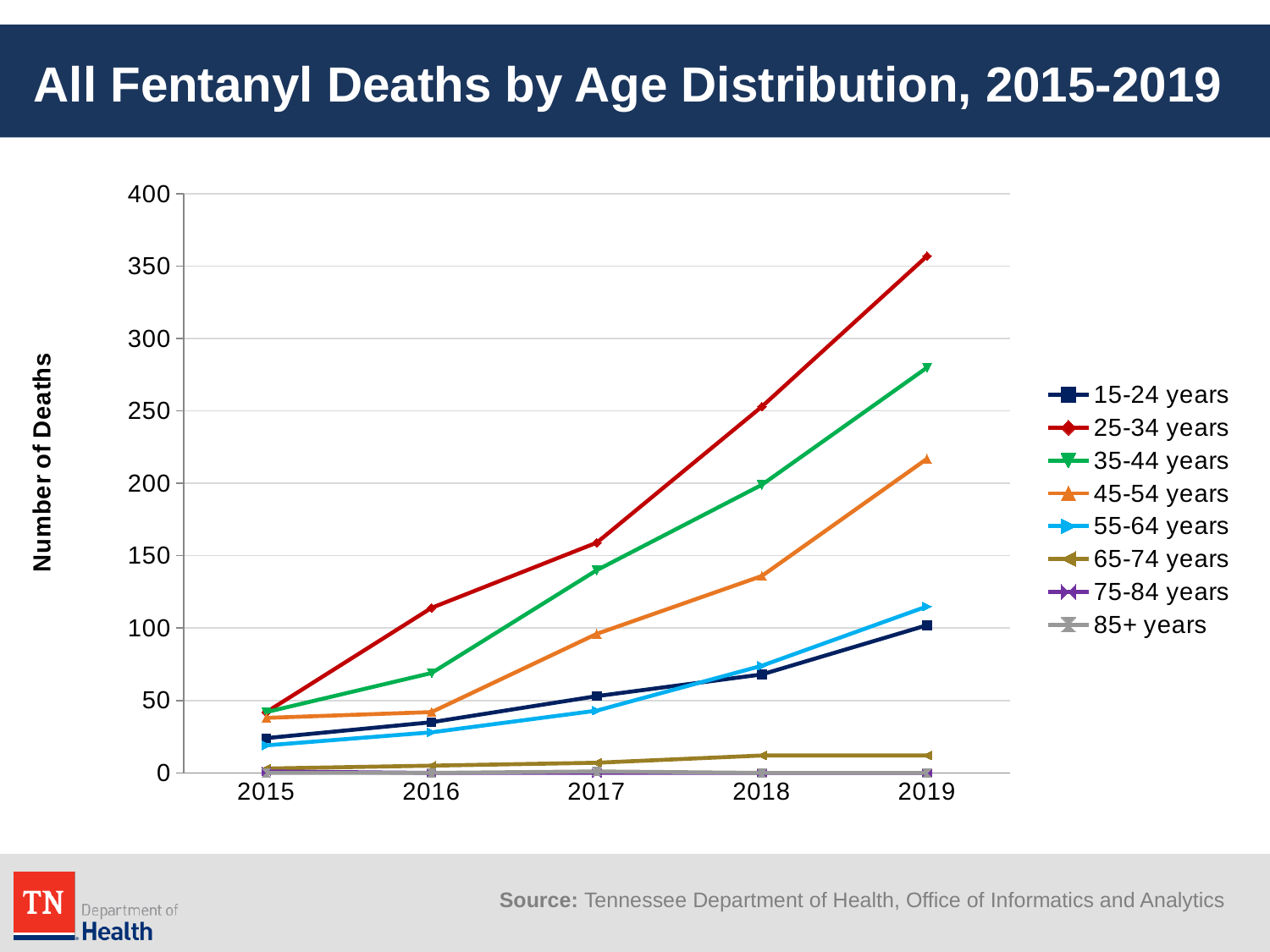
Do the deaths for 25-34 years rise or fall from 2015 to 2019? rise What is the title of the y axis? Number of Deaths How many series does the legend list? 8 How many years are shown along the x axis? 5 What kind of chart is shown on the slide? line chart Is the value for 25-34 years in 2016 greater or less than 100? greater Is the value for 35-44 years in 2019 greater or less than 250? greater Is the value for 65-74 years in 2019 greater or less than 50? less Which is larger in 2019, the value for 35-44 years or the value for 45-54 years? 35-44 years Which age group has the highest number of deaths in 2019? 25-34 years